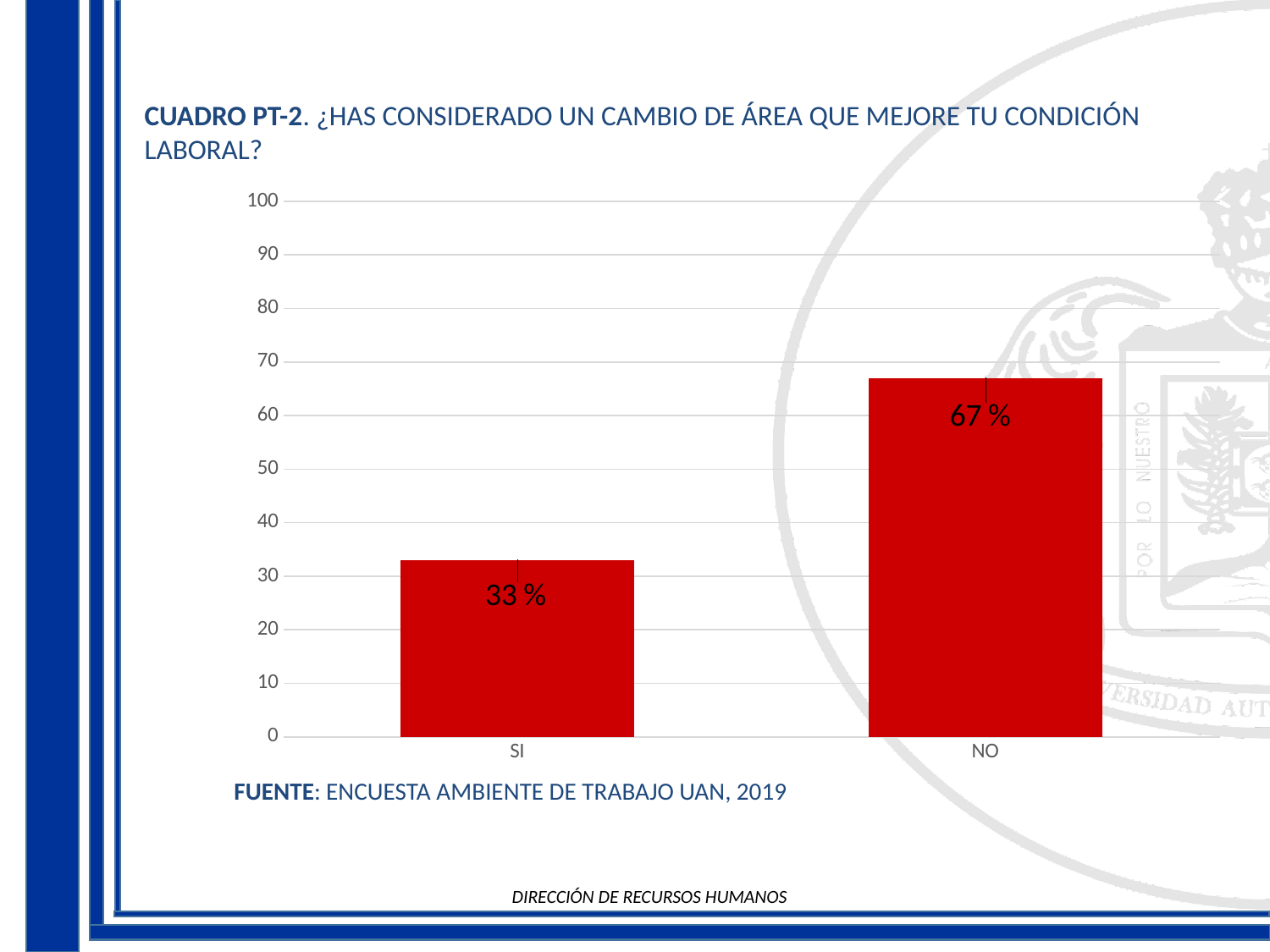
What colour are the bars in the chart? red What is the difference between the values for NO and SI? 34 % Is the value for SI greater or less than 40? less What kind of chart is shown on the slide? bar chart What is the source cited below the chart? ENCUESTA AMBIENTE DE TRABAJO UAN, 2019 Which category has the highest value? NO What is the value for NO? 67 % What is the value for SI? 33 % Which is larger, the value for SI or the value for NO? NO Which category has the lowest value? SI How many categories are shown on the x axis? 2 Is the value for NO greater or less than 60? greater